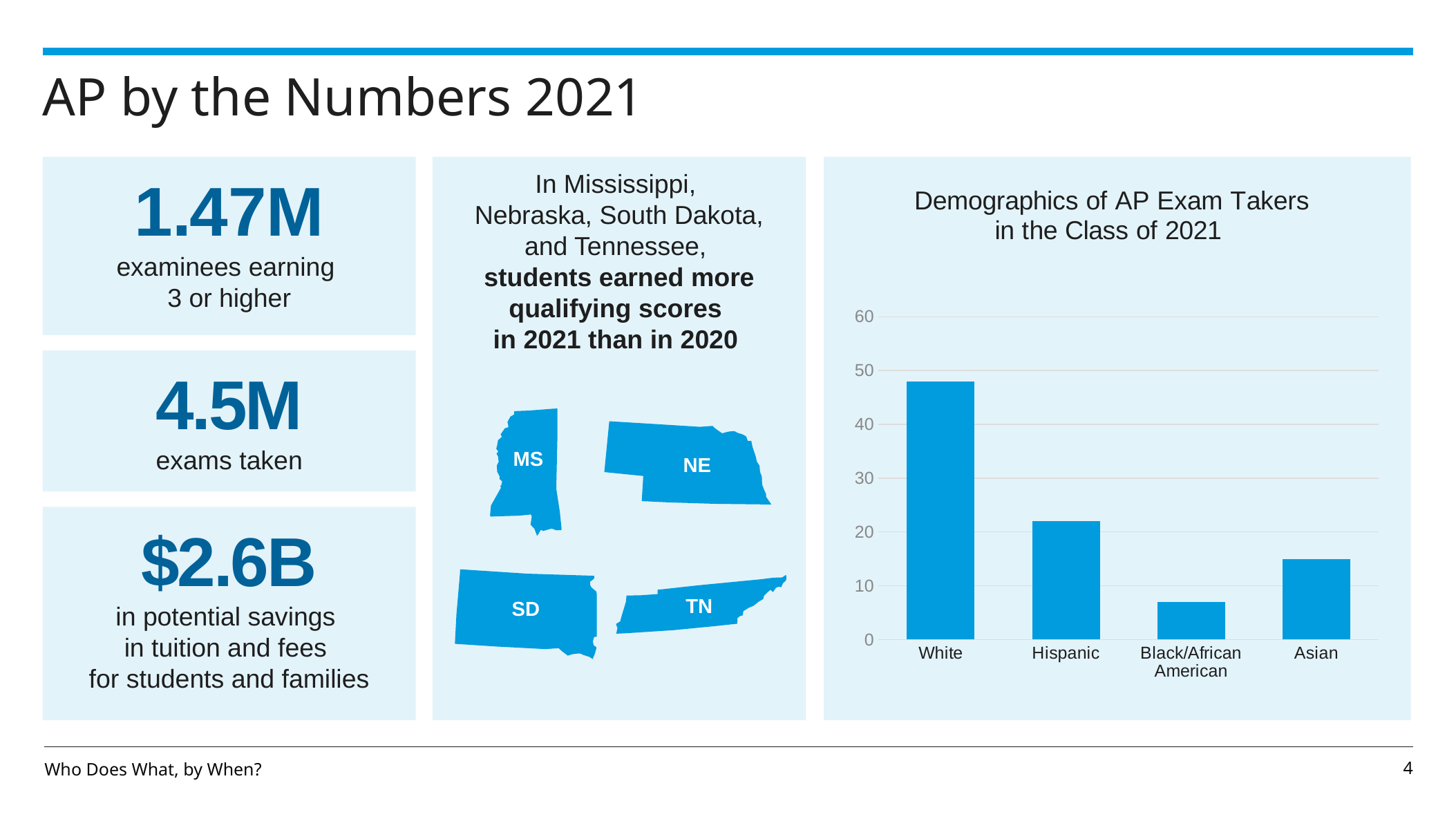
Which category has the highest bar in the Demographics of AP Exam Takers chart? White What is the highest value labelled on the y axis of the Demographics of AP Exam Takers chart? 60 How many categories are shown on the x axis of the Demographics of AP Exam Takers chart? 4 In the Demographics of AP Exam Takers chart, is the value for Hispanic greater or less than 30? less In the Demographics of AP Exam Takers chart, is the value for White greater or less than 40? greater Which category has the lowest bar in the Demographics of AP Exam Takers chart? Black/African American What is the title of the chart on the right side of the slide? Demographics of AP Exam Takers in the Class of 2021 In the Demographics of AP Exam Takers chart, which is larger, the value for Asian or the value for Black/African American? Asian In the Demographics of AP Exam Takers chart, is the value for Black/African American greater or less than 10? less In the Demographics of AP Exam Takers chart, which is larger, the value for Hispanic or the value for Asian? Hispanic What kind of chart is shown under the title "Demographics of AP Exam Takers in the Class of 2021"? bar chart